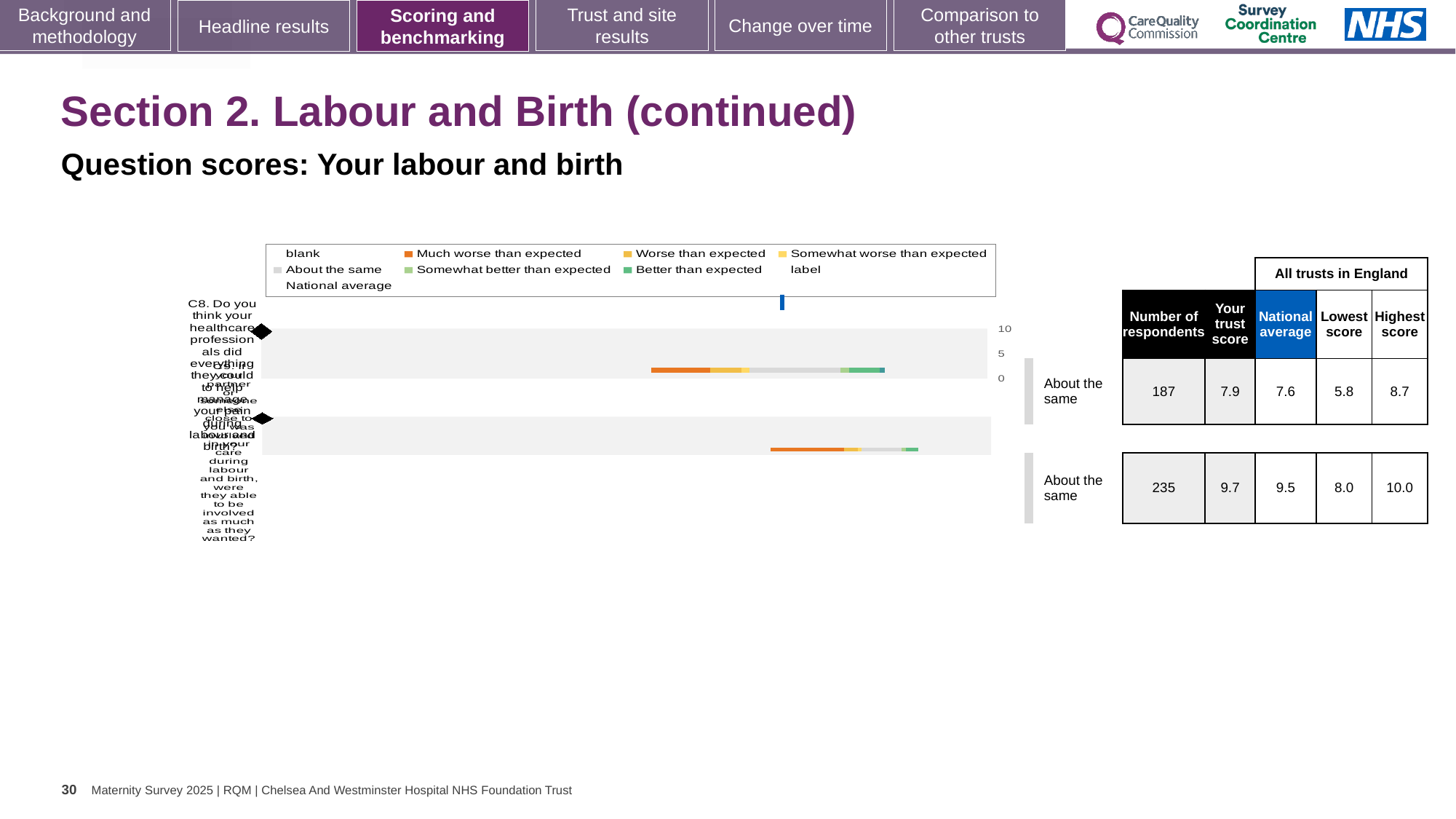
What is the national average for the first row (C8)? 7.6 What is the 'Your trust score' for the first row (C8, managing pain during labour and birth)? 7.9 What benchmark category is shown for both rows in the chart? About the same How many respondents are listed for the first row (C8)? 187 For the first row (C8), which is larger: the trust score or the national average? the trust score For the first row (C8), what is the difference between the highest and lowest scores across all trusts in England? 2.9 What kind of chart is shown on the slide? bar chart What is the highest score across all trusts in England for the second row? 10.0 What is the lowest score across all trusts in England for the second row? 8.0 For the second row, what is the difference between the trust score and the national average? 0.2 How many question rows are plotted in the chart? 2 What colour represents 'Much worse than expected' in the legend? orange